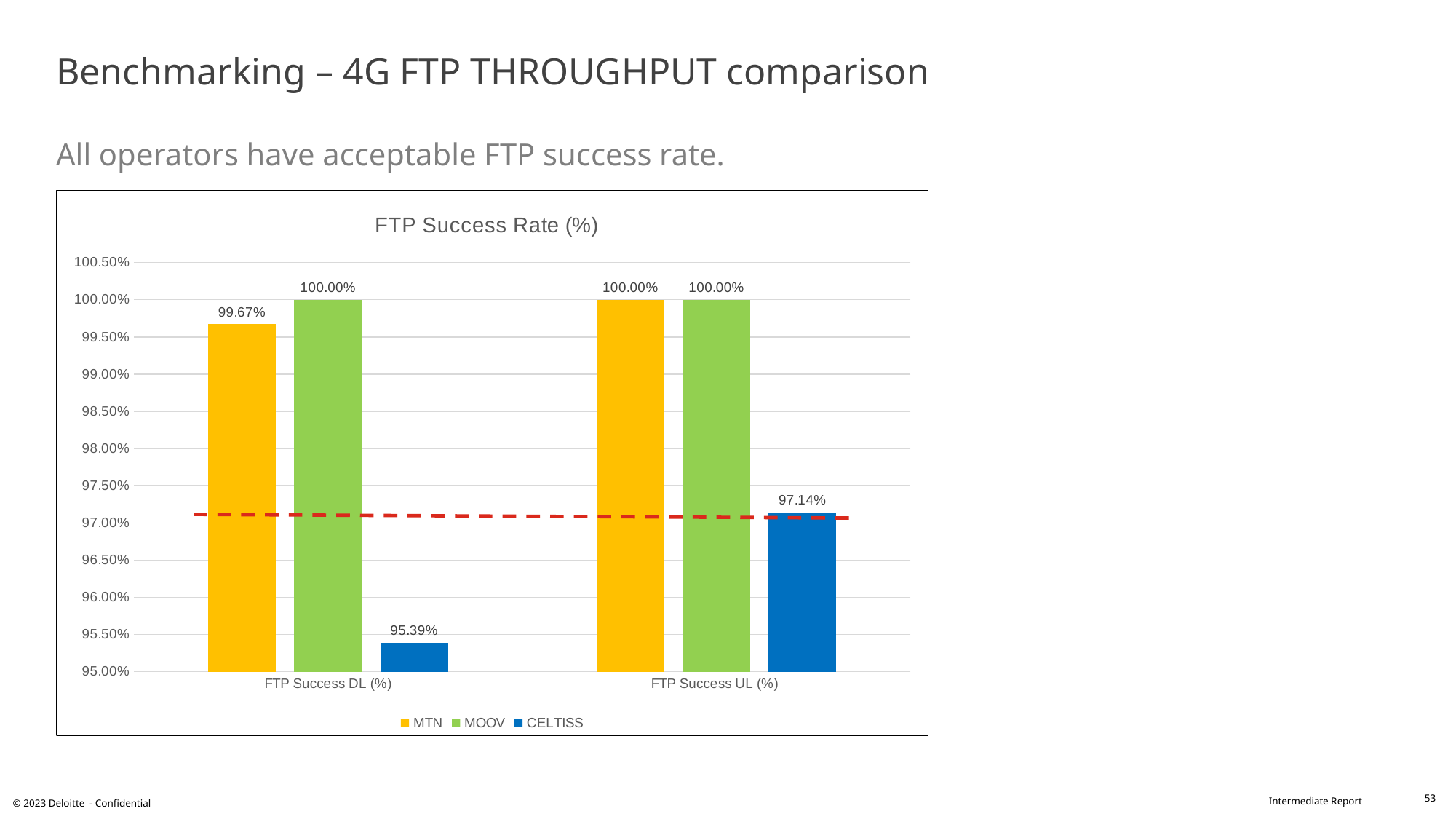
What is the difference between CELTISS's FTP Success UL (%) and FTP Success DL (%) values? 1.75% What is the FTP Success UL (%) value for CELTISS? 97.14% What kind of chart is shown on the slide? Bar chart Which operator has the lowest FTP Success UL (%)? CELTISS What is the difference between MOOV's and MTN's FTP Success DL (%) values? 0.33% What is the title of the chart? FTP Success Rate (%) Which is larger: MTN's FTP Success DL (%) or CELTISS's FTP Success UL (%)? MTN's FTP Success DL (%) What is the FTP Success DL (%) value for MTN? 99.67% How many series does the legend list? 3 Which operator has the lowest FTP Success DL (%)? CELTISS What is the FTP Success DL (%) value for CELTISS? 95.39% What is the FTP Success UL (%) value for MTN? 100.00%